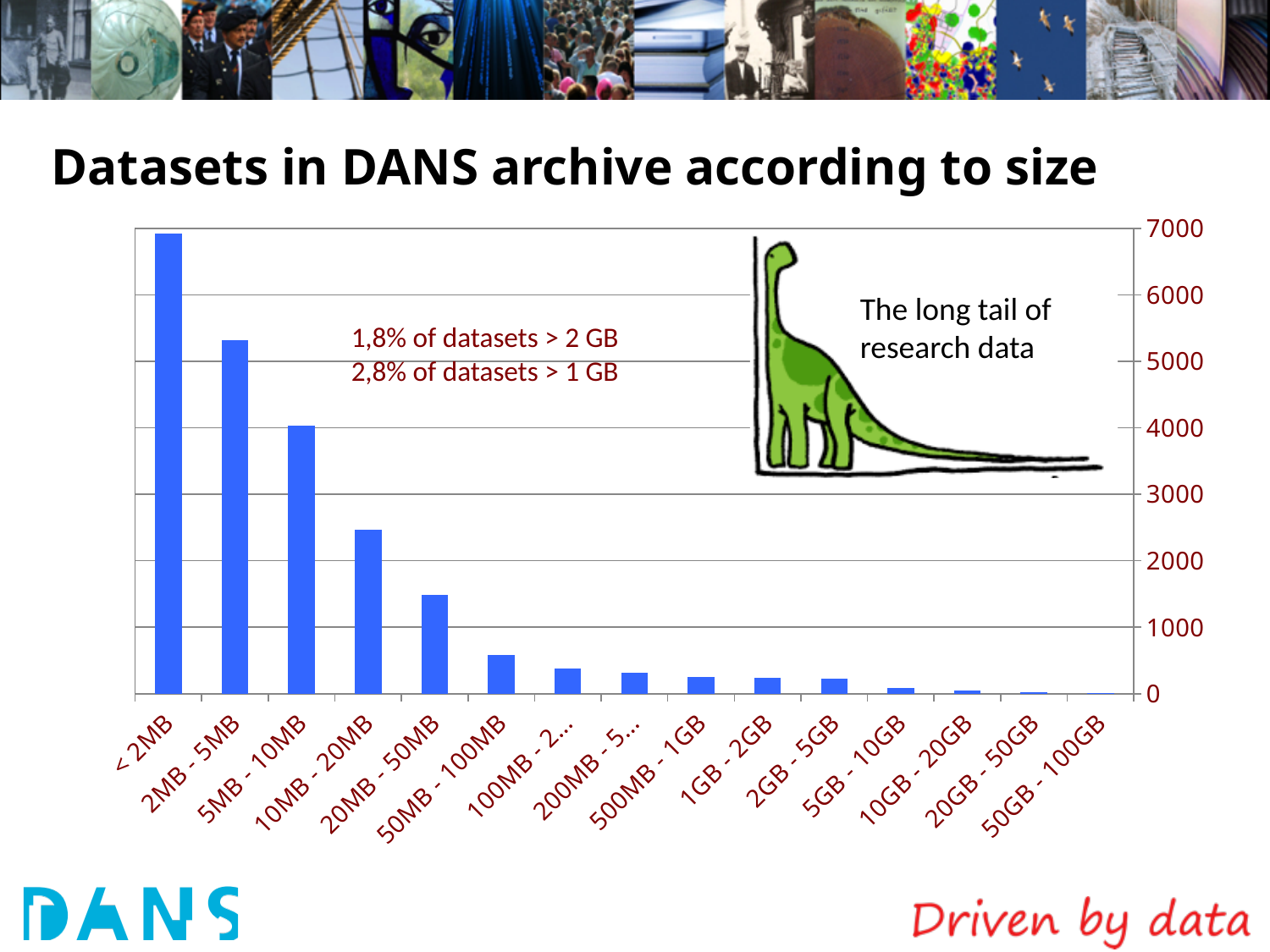
Is the value for 10MB - 20MB greater or less than 2000? greater Which is larger, the value for 2MB - 5MB or the value for 10MB - 20MB? 2MB - 5MB Is the value for < 2MB greater or less than 6000? greater Is the value for 20MB - 50MB greater or less than 1000? greater How many size categories are shown on the x axis of the chart? 15 What is the title of the chart on the slide? Datasets in DANS archive according to size Do the values rise or fall as the size categories increase along the x axis? fall Which size category has the highest number of datasets? < 2MB According to the annotation on the chart, what percentage of datasets are larger than 2 GB? 1,8% What kind of chart is shown on the slide? bar chart